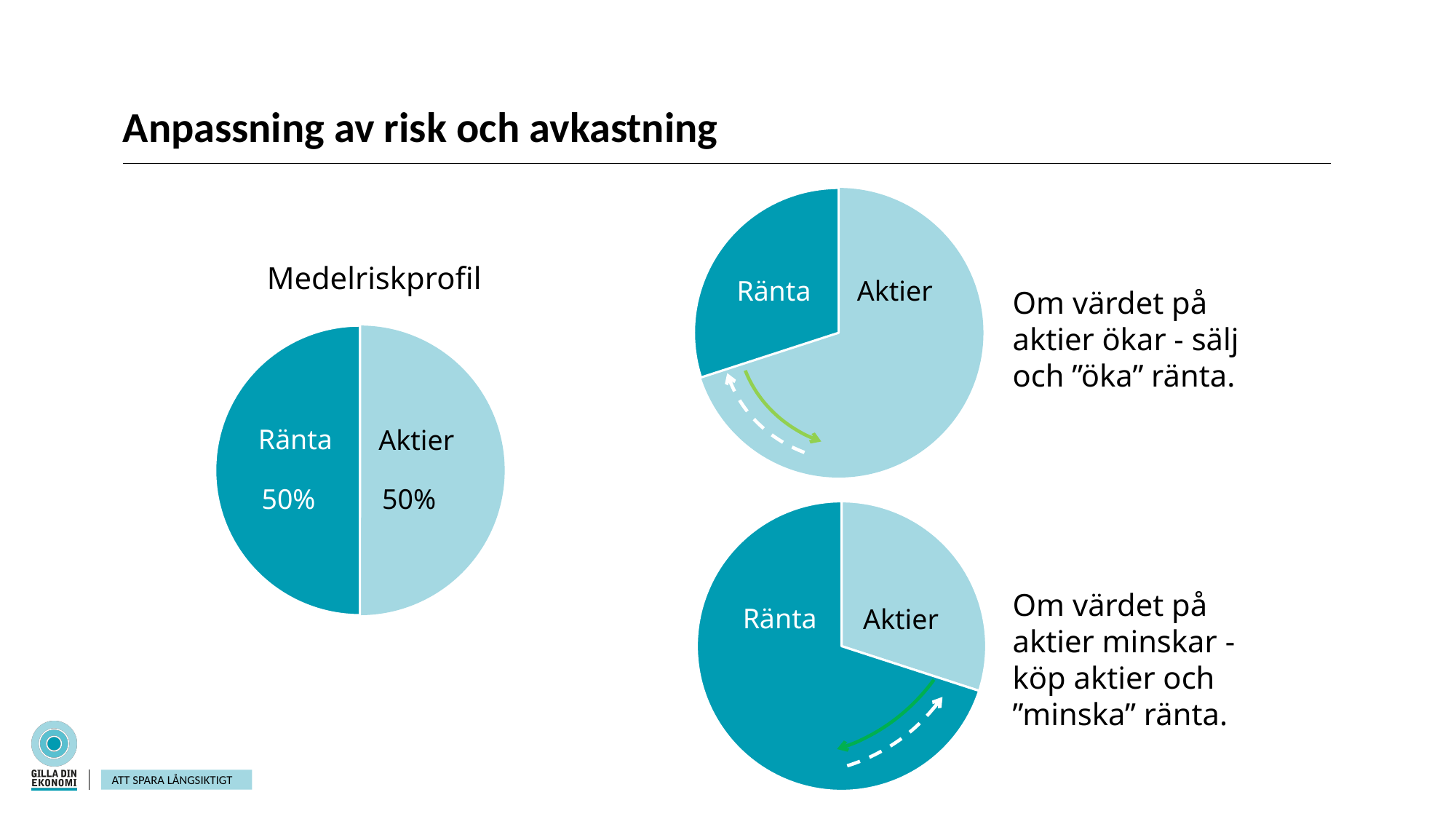
How many pie charts are shown on the slide? 3 What kind of chart is the Medelriskprofil chart? Pie chart In the Medelriskprofil pie chart, what share does Ränta have? 50% In the bottom-right pie chart, which slice is larger, Ränta or Aktier? Ränta How many slices does the Medelriskprofil pie chart have? 2 In the top-right pie chart, which slice is larger, Ränta or Aktier? Aktier In the Medelriskprofil pie chart, what is the difference between the Ränta share and the Aktier share? 0% In the bottom-right pie chart, which slice is the largest? Ränta In the Medelriskprofil pie chart, which slice is shown in the darker teal colour? Ränta What is the title of the pie chart on the left side of the slide? Medelriskprofil In the top-right pie chart, which slice is the smallest? Ränta In the Medelriskprofil pie chart, what share does Aktier have? 50%